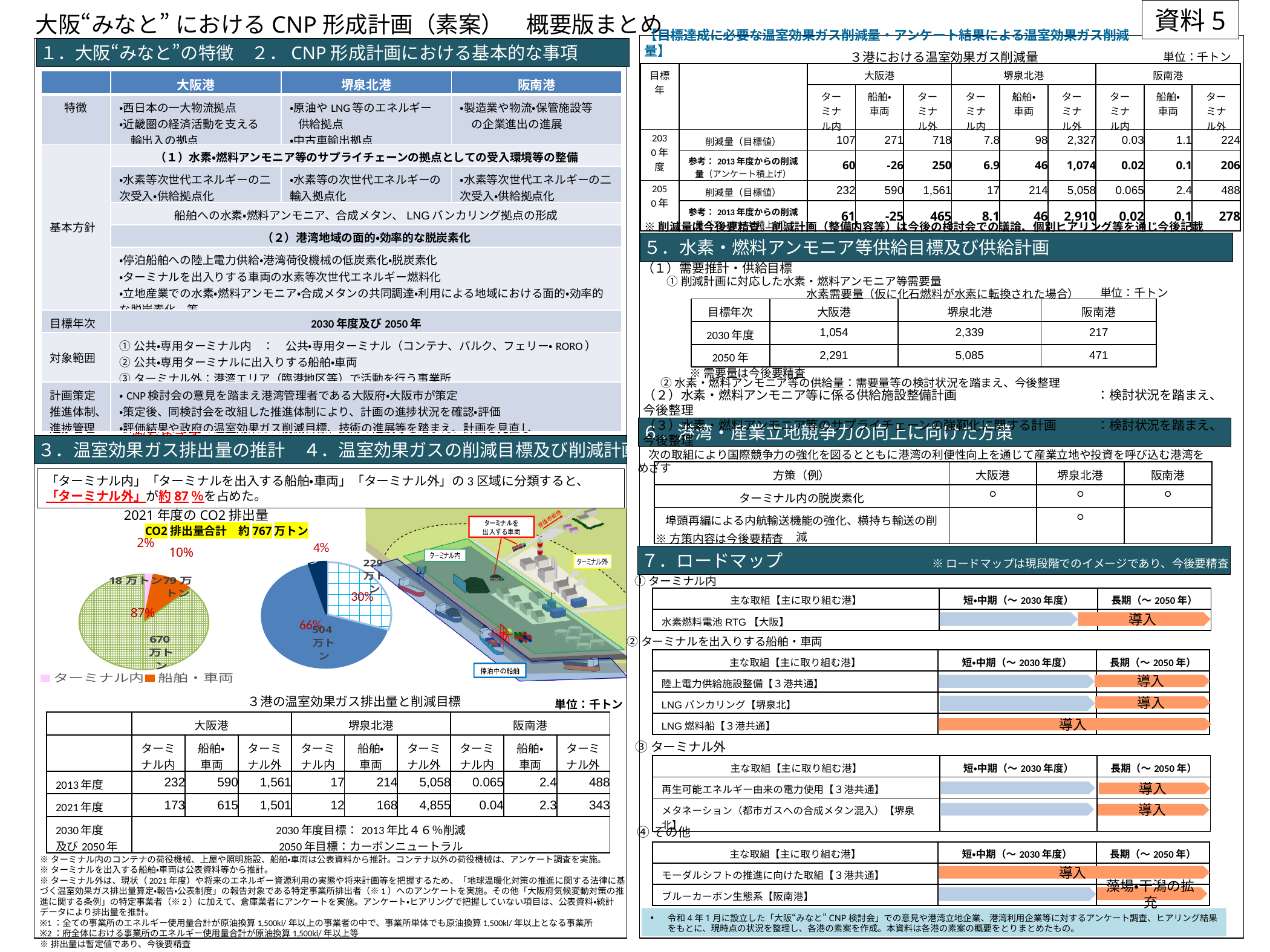
In the left pie chart of 2021年度のCO2排出量, which category has the smallest slice? ターミナル内 In the left pie chart of 2021年度のCO2排出量, what share does 船舶・車両 account for? 10% How many slices does the left pie chart of 2021年度のCO2排出量 have? 3 What is the CO2排出量合計 stated above the pie charts for 2021年度? 約767万トン In the left pie chart of 2021年度のCO2排出量, what is the emission value for ターミナル外? 670万トン In the left pie chart of 2021年度のCO2排出量, what is the emission value for ターミナル内? 18万トン In the right pie chart of 2021年度のCO2排出量, what is the value of the slice labelled 66%? 504万トン In the left pie chart of 2021年度のCO2排出量, which category has the largest slice? ターミナル外 In the left pie chart of 2021年度のCO2排出量, what is the emission value for 船舶・車両? 79万トン What kind of chart is used to show the 2021年度のCO2排出量 breakdown on the left of the slide? pie chart In the left pie chart of 2021年度のCO2排出量, which is larger, 船舶・車両 or ターミナル内? 船舶・車両 In the left pie chart of 2021年度のCO2排出量, what share of emissions does ターミナル外 account for? 87%